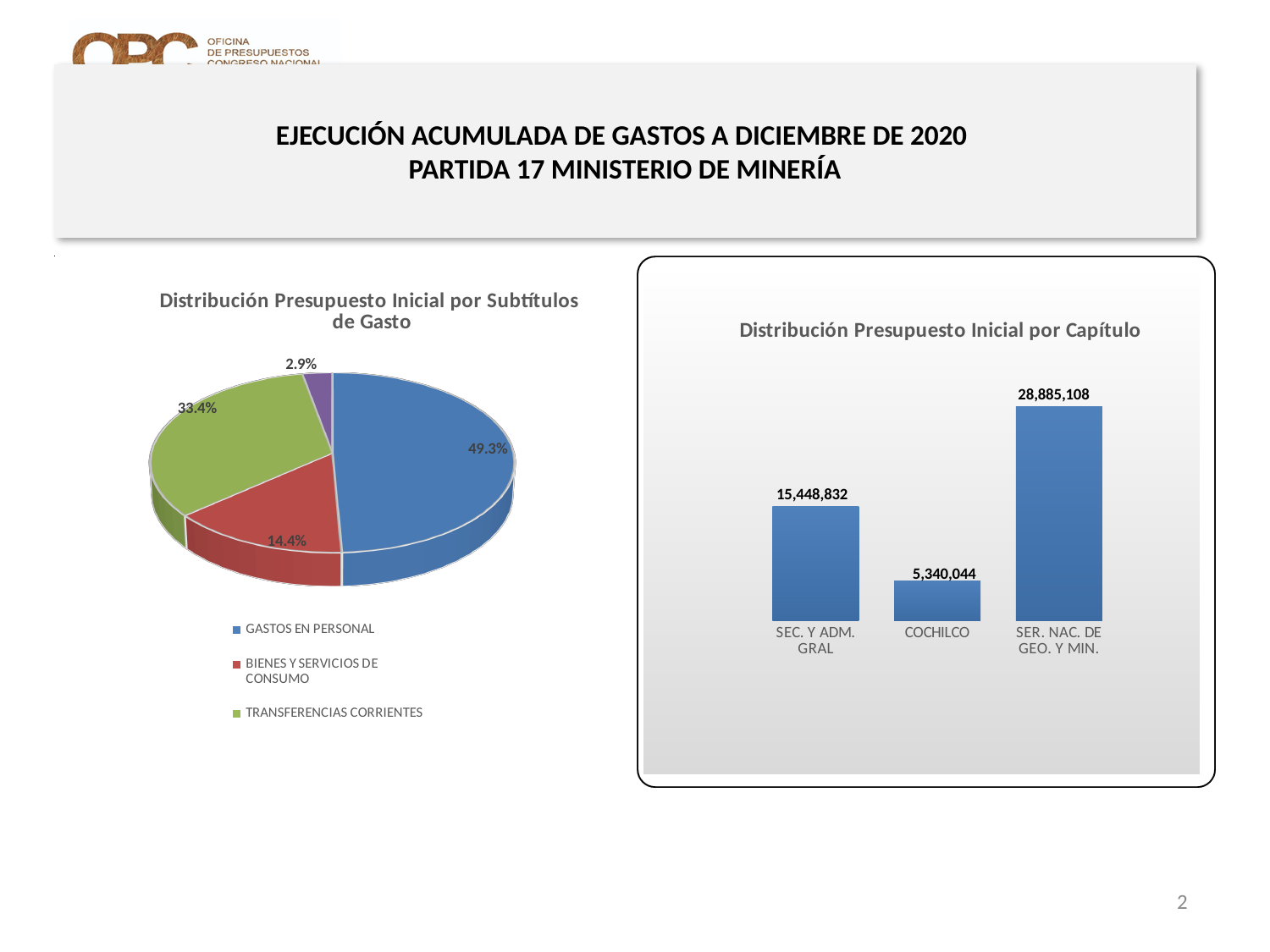
In the 'Distribución Presupuesto Inicial por Capítulo' chart, what is the value for SER. NAC. DE GEO. Y MIN.? 28,885,108 How many entries does the legend of the 'Distribución Presupuesto Inicial por Subtítulos de Gasto' pie chart list? 3 What kind of chart is 'Distribución Presupuesto Inicial por Capítulo'? Bar chart In the 'Distribución Presupuesto Inicial por Capítulo' chart, which category has the lowest value? COCHILCO In the 'Distribución Presupuesto Inicial por Capítulo' chart, what is the difference between SER. NAC. DE GEO. Y MIN. and SEC. Y ADM. GRAL? 13,436,276 In the 'Distribución Presupuesto Inicial por Subtítulos de Gasto' pie chart, what share does TRANSFERENCIAS CORRIENTES have? 33.4% In the 'Distribución Presupuesto Inicial por Capítulo' chart, which category has the highest value? SER. NAC. DE GEO. Y MIN. In the 'Distribución Presupuesto Inicial por Subtítulos de Gasto' pie chart, what share does GASTOS EN PERSONAL have? 49.3% In the 'Distribución Presupuesto Inicial por Capítulo' chart, what is the value for COCHILCO? 5,340,044 In the 'Distribución Presupuesto Inicial por Subtítulos de Gasto' pie chart, which is larger: BIENES Y SERVICIOS DE CONSUMO or TRANSFERENCIAS CORRIENTES? TRANSFERENCIAS CORRIENTES In the 'Distribución Presupuesto Inicial por Capítulo' chart, how many categories are shown? 3 In the 'Distribución Presupuesto Inicial por Capítulo' chart, what is the value for SEC. Y ADM. GRAL? 15,448,832